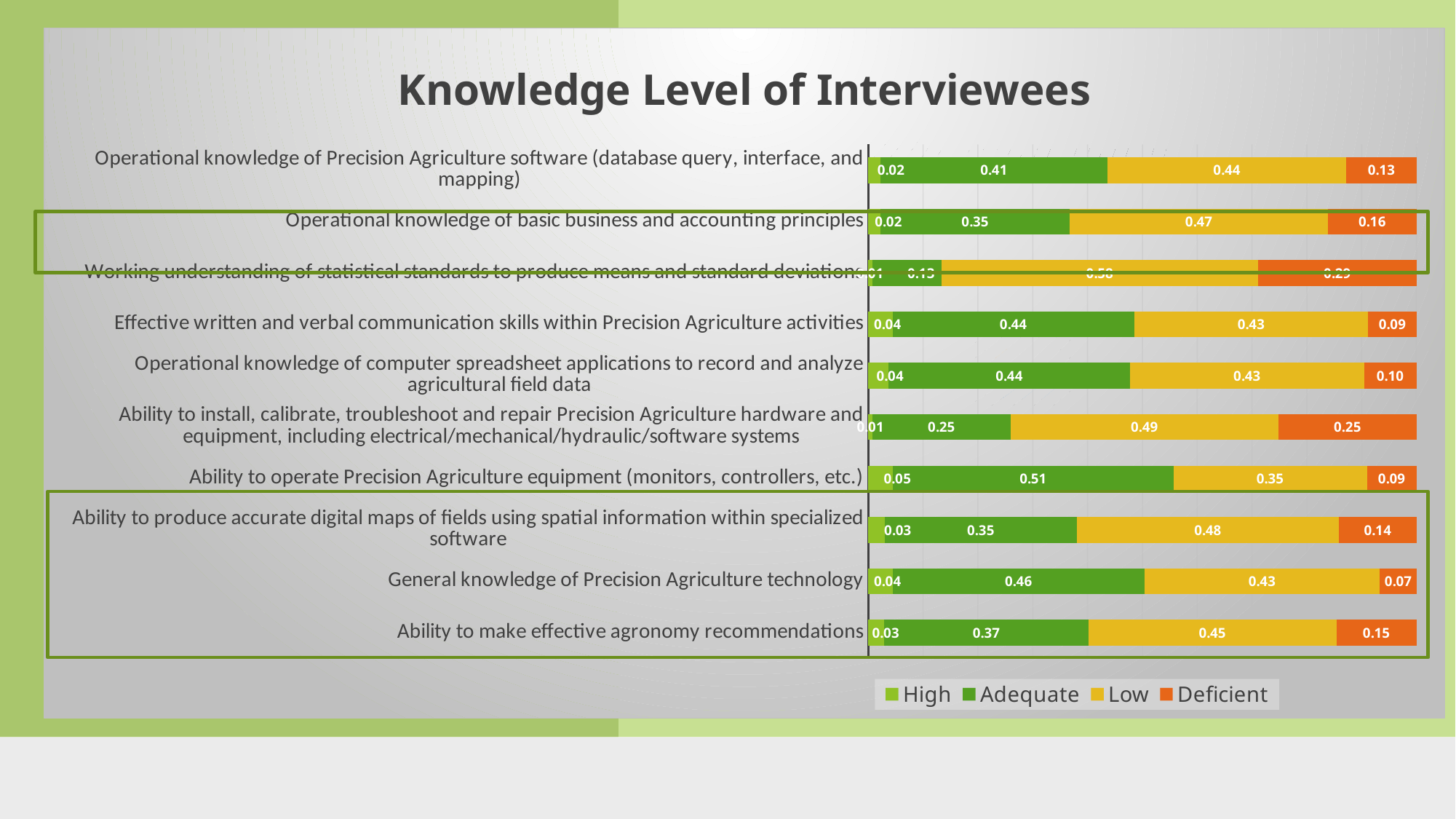
How many series does the legend list? 4 What is the total of the stacked bar for "General knowledge of Precision Agriculture technology"? 1.00 Which category has the highest Adequate value? Ability to operate Precision Agriculture equipment (monitors, controllers, etc.) What is the High value for "General knowledge of Precision Agriculture technology"? 0.04 What kind of chart is shown on the slide? Stacked bar chart What is the Deficient value for "Operational knowledge of basic business and accounting principles"? 0.16 Which is larger: the Deficient value for "Ability to make effective agronomy recommendations" or the Deficient value for "Effective written and verbal communication skills within Precision Agriculture activities"? Ability to make effective agronomy recommendations What is the difference between the Low value and the Adequate value for "Ability to install, calibrate, troubleshoot and repair Precision Agriculture hardware and equipment, including electrical/mechanical/hydraulic/software systems"? 0.24 How many categories are shown in the chart? 10 What is the Low value for "Ability to produce accurate digital maps of fields using spatial information within specialized software"? 0.48 Which category has the lowest Deficient value? General knowledge of Precision Agriculture technology What is the Adequate value for "Ability to operate Precision Agriculture equipment (monitors, controllers, etc.)"? 0.51